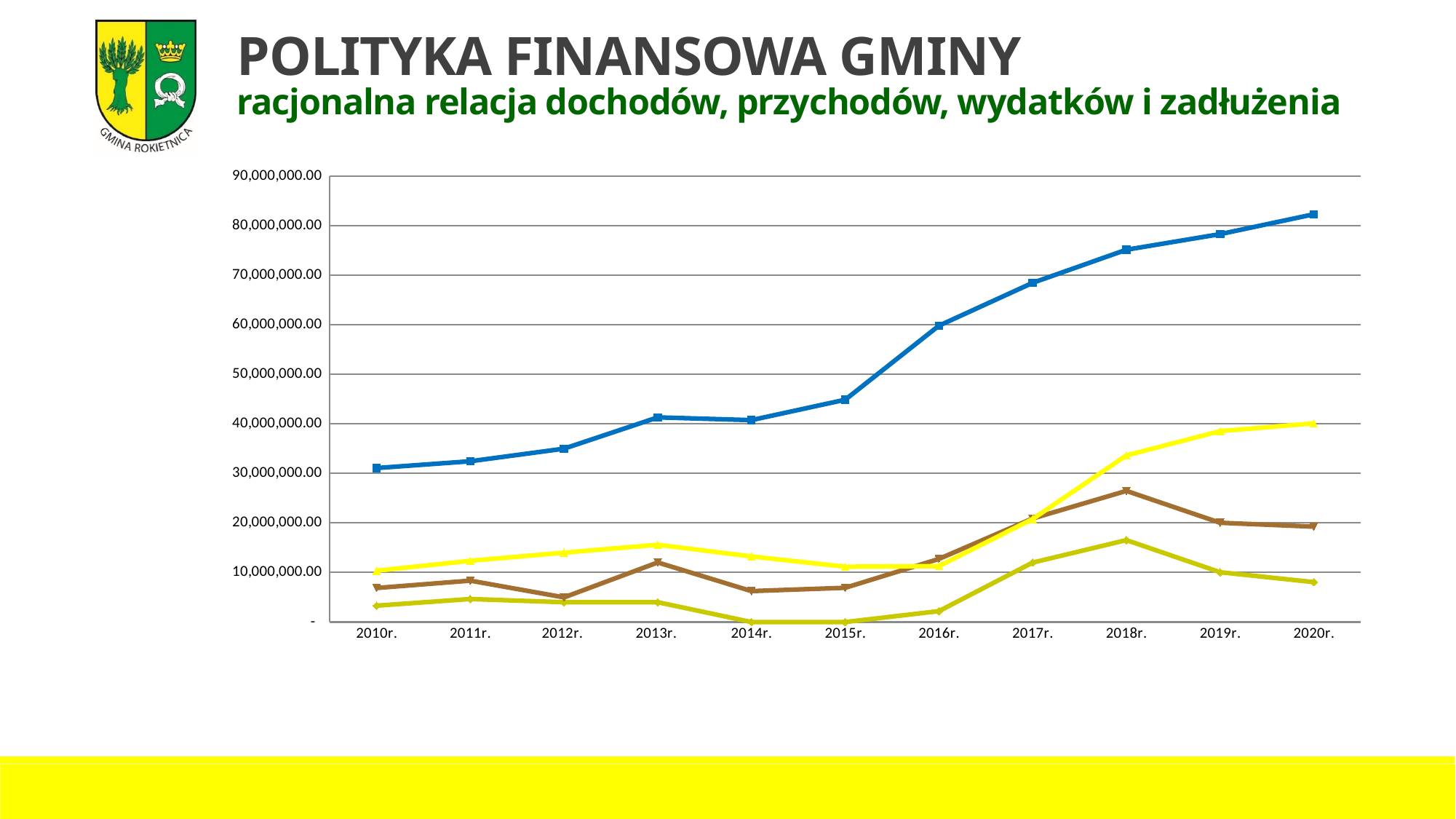
What kind of chart is shown on the slide? line chart Does the blue line rise or fall from 2010r. to 2020r.? rise In 2020r., which is larger: the yellow line or the brown line? yellow line How many years are plotted along the x axis? 11 What is the first year shown on the x axis? 2010r. Is the value of the brown line for 2018r. greater or less than 20,000,000.00? greater Is the value of the yellow line for 2018r. greater or less than 30,000,000.00? greater Is the value of the blue line for 2017r. greater or less than 70,000,000.00? less In which year does the brown line reach its highest value? 2018r. In which year does the blue line reach its highest value? 2020r. What is the highest value shown on the y axis? 90,000,000.00